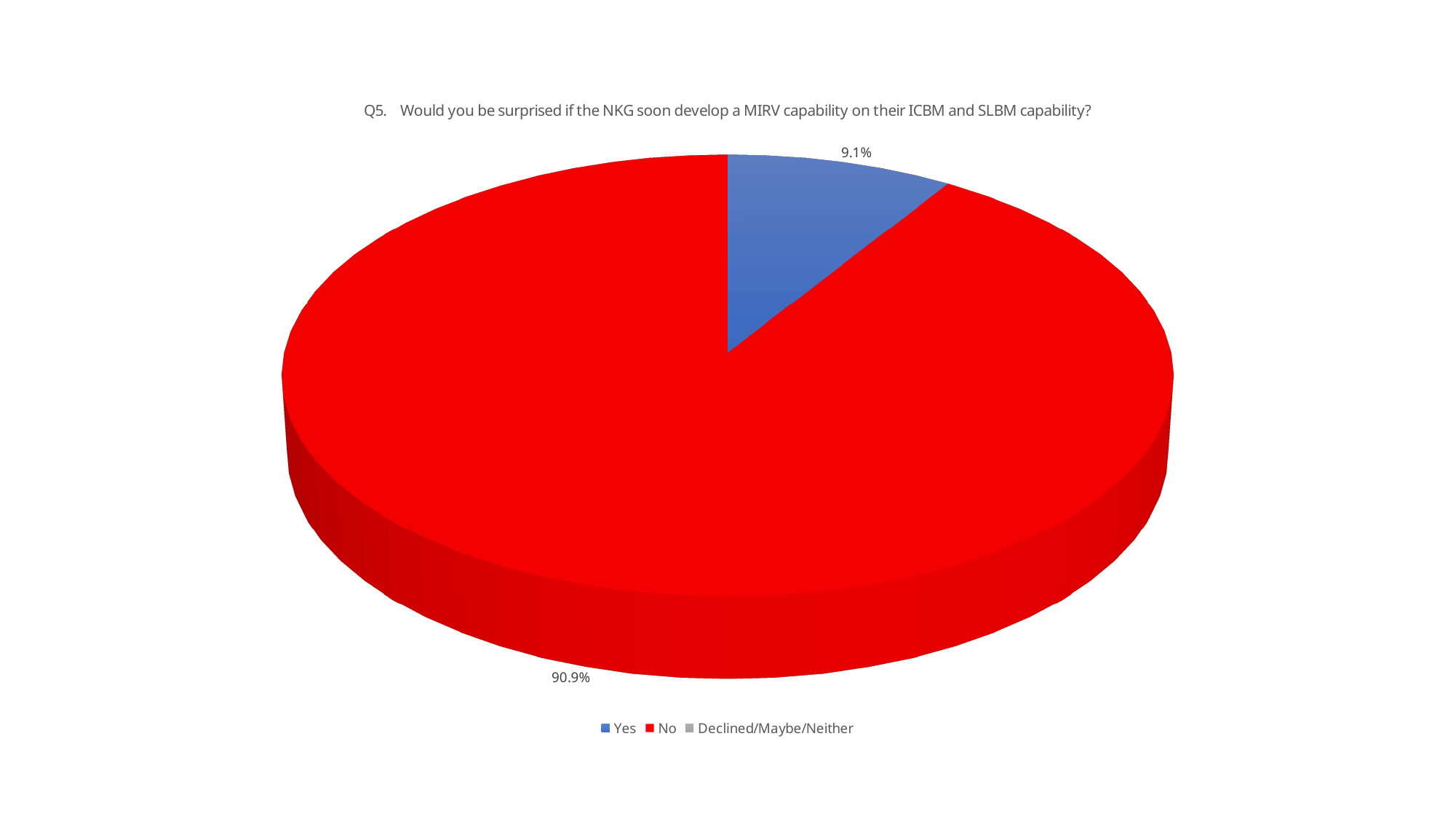
What colour is the "No" slice? Red What is the title of the chart? Q5. Would you be surprised if the NKG soon develop a MIRV capability on their ICBM and SLBM capability? Which response has the largest slice of the pie? No What kind of chart is shown on the slide? Pie chart How many entries does the legend list? 3 What share of the pie does the "Yes" slice represent? 9.1% Which of the two visible slices, Yes or No, is smaller? Yes What is the total of the two labelled slices? 100% What share of the pie does the "No" slice represent? 90.9% Is the "No" slice larger or smaller than the "Yes" slice? Larger What is the difference in percentage points between the "No" and "Yes" slices? 81.8% How many slices are visible in the pie? 2